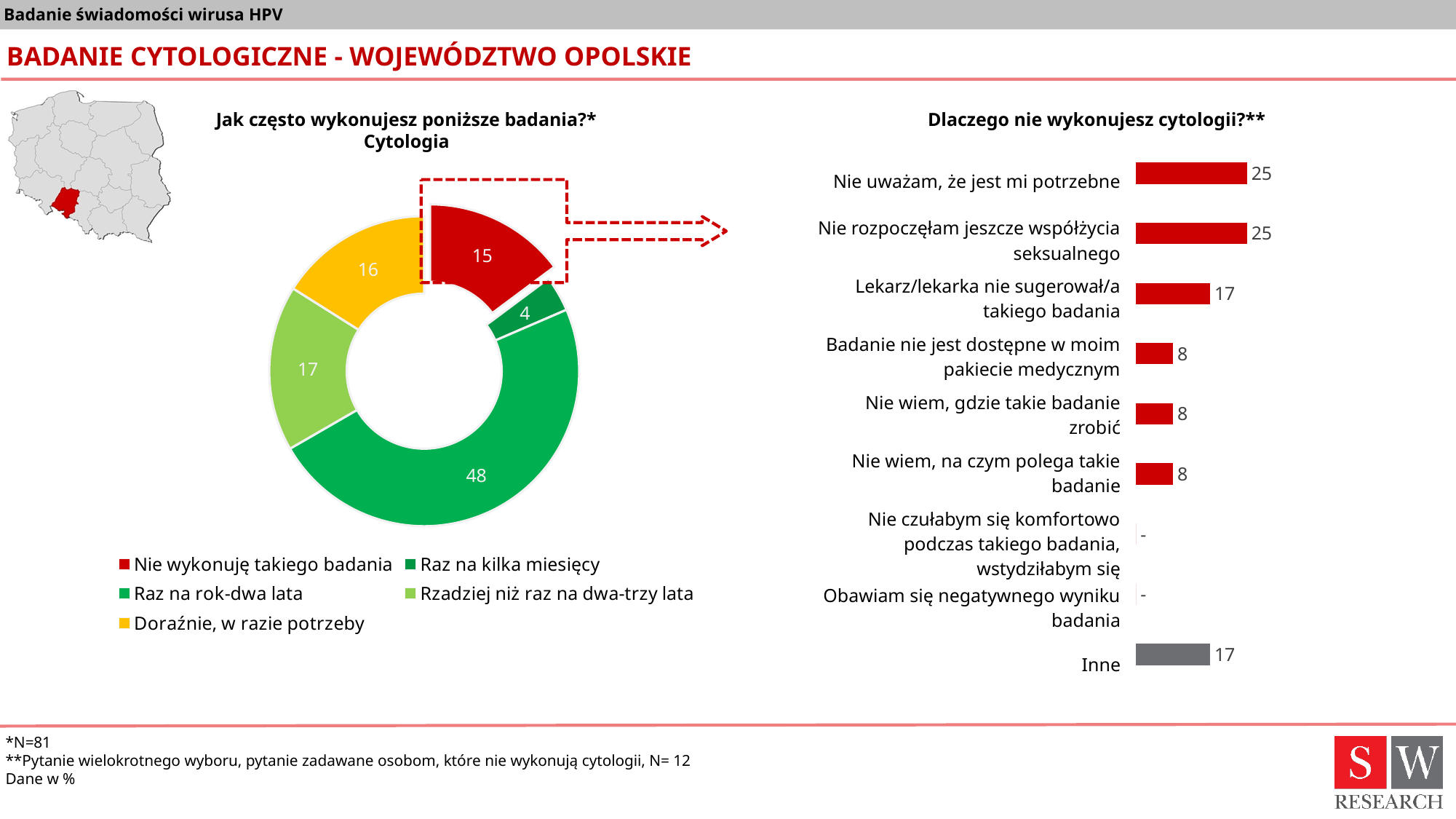
In the donut chart 'Jak często wykonujesz poniższe badania? Cytologia', which category has the largest value? Raz na rok-dwa lata How many categories does the legend of the donut chart 'Jak często wykonujesz poniższe badania? Cytologia' list? 5 In the donut chart 'Jak często wykonujesz poniższe badania? Cytologia', what is the value for 'Raz na rok-dwa lata'? 48 In the bar chart 'Dlaczego nie wykonujesz cytologii?', what is the value for 'Lekarz/lekarka nie sugerował/a takiego badania'? 17 In the bar chart 'Dlaczego nie wykonujesz cytologii?', what is the value for 'Nie wiem, gdzie takie badanie zrobić'? 8 In the donut chart 'Jak często wykonujesz poniższe badania? Cytologia', which category has the smallest value? Raz na kilka miesięcy In the bar chart 'Dlaczego nie wykonujesz cytologii?', which bar is shown in grey rather than red? Inne In the donut chart 'Jak często wykonujesz poniższe badania? Cytologia', what is the value for 'Nie wykonuję takiego badania'? 15 In the donut chart 'Jak często wykonujesz poniższe badania? Cytologia', what is the difference between 'Rzadziej niż raz na dwa-trzy lata' and 'Doraźnie, w razie potrzeby'? 1 What type of chart is 'Dlaczego nie wykonujesz cytologii?'? Bar chart In the bar chart 'Dlaczego nie wykonujesz cytologii?', what is the difference between 'Nie rozpoczęłam jeszcze współżycia seksualnego' and 'Inne'? 8 In the bar chart 'Dlaczego nie wykonujesz cytologii?', which is larger: 'Nie uważam, że jest mi potrzebne' or 'Badanie nie jest dostępne w moim pakiecie medycznym'? Nie uważam, że jest mi potrzebne